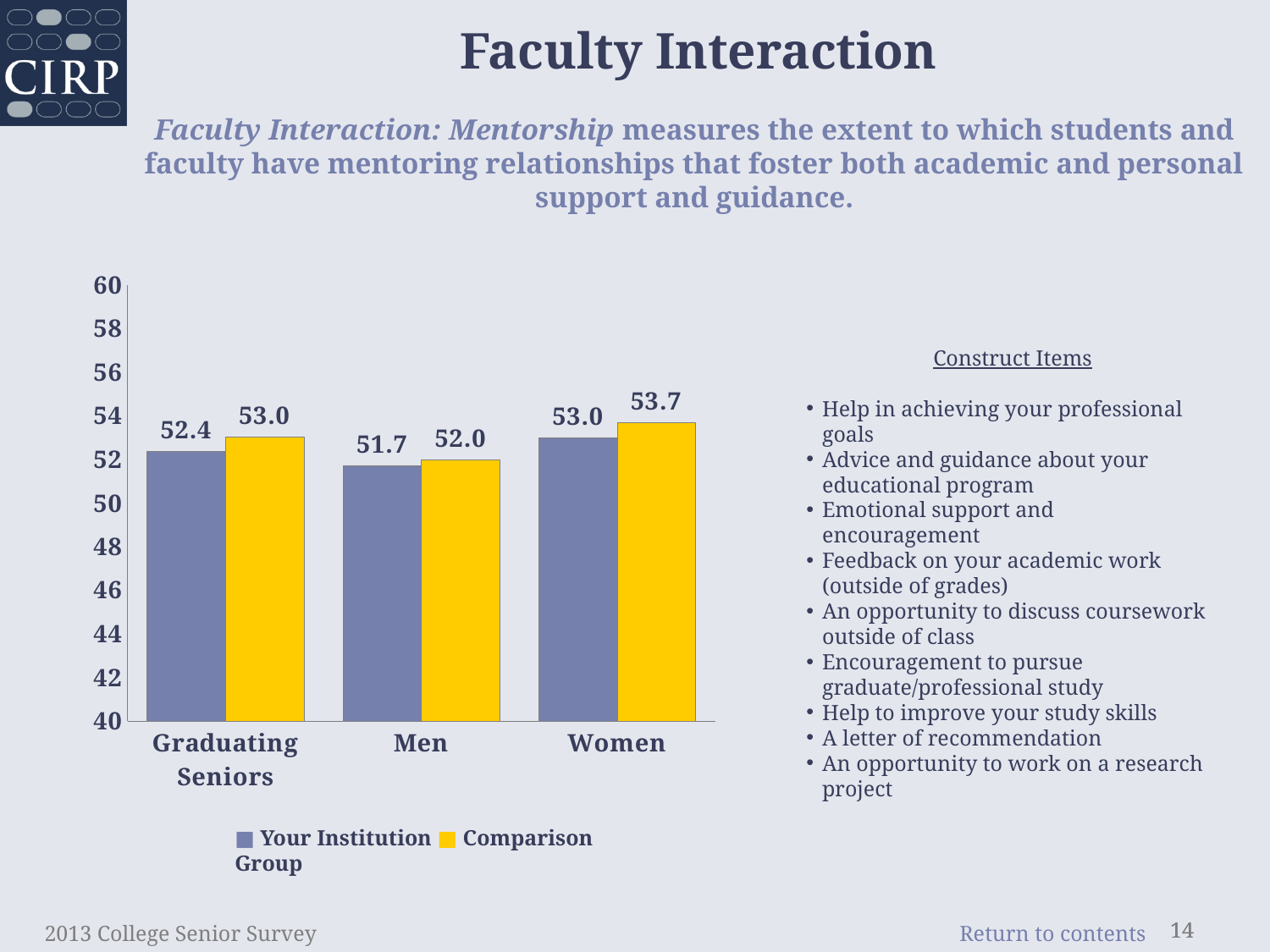
Which is larger for Men: Your Institution or Comparison Group? Comparison Group How many categories are shown on the x axis? 3 What is the value for Your Institution for Graduating Seniors? 52.4 What is the difference between the Comparison Group and Your Institution values for Graduating Seniors? 0.6 What is the difference between the Comparison Group and Your Institution values for Women? 0.7 How many series does the legend list? 2 Which category has the highest Comparison Group value? Women What kind of chart is shown on the slide? bar chart What is the Comparison Group value for Women? 53.7 What is the Your Institution value for Men? 51.7 Is the Your Institution value for Women greater or less than 50? greater Which category has the lowest Your Institution value? Men